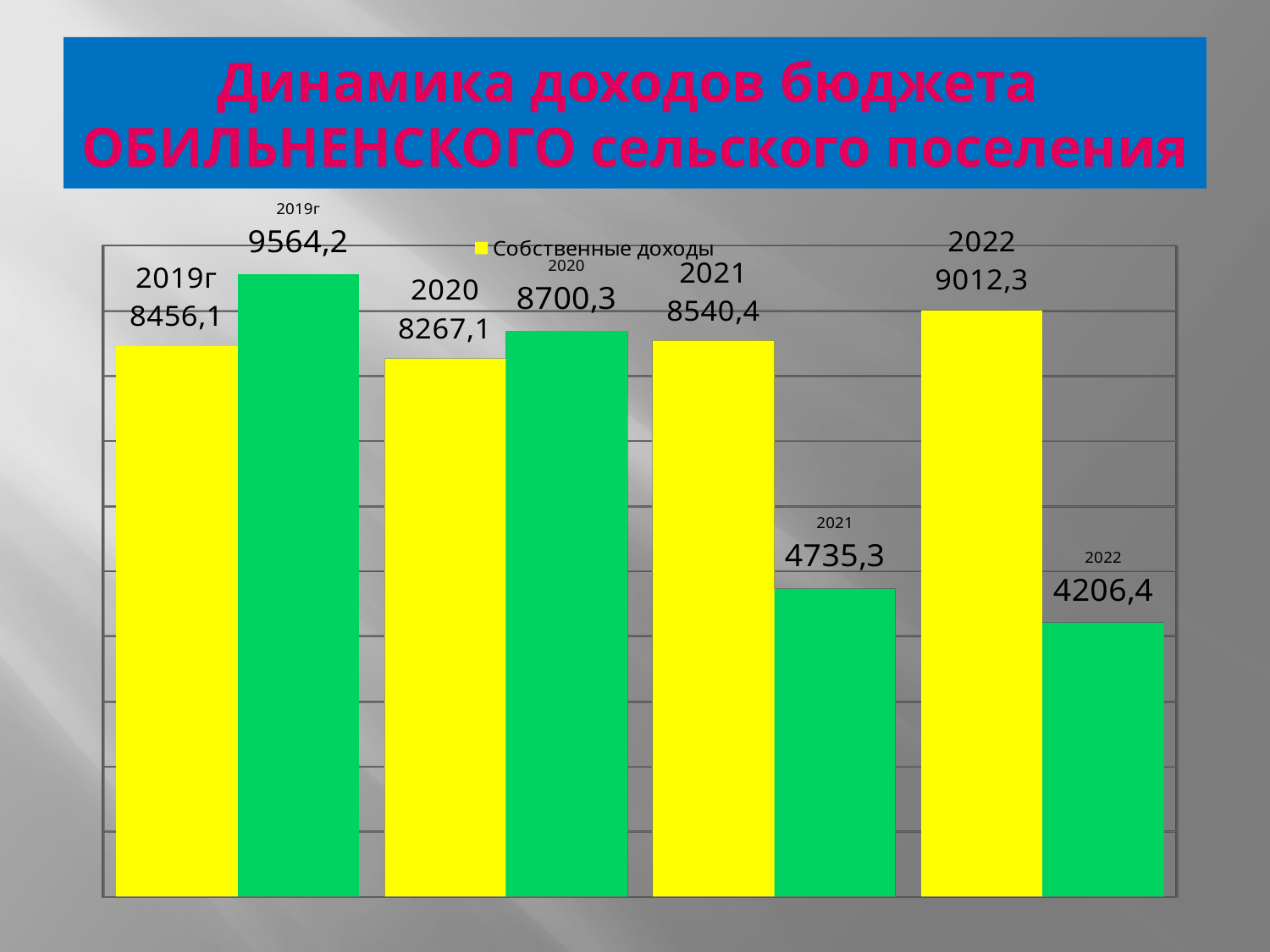
What is the value of Собственные доходы for 2019г? 8456,1 What is the value of Собственные доходы for 2022? 9012,3 Do the green bar values rise or fall from 2019г to 2022? fall In which year is Собственные доходы the highest? 2022 What is the difference between the green bar value for 2019г and the green bar value for 2022? 5357,8 What kind of chart is shown on the slide? bar chart In which year is Собственные доходы the lowest? 2020 What value is printed on the green bar for 2021? 4735,3 What value is printed on the green bar for 2020? 8700,3 What is the difference between Собственные доходы in 2022 and in 2021? 471,9 For 2019г, which is larger: the yellow bar (Собственные доходы) or the green bar? the green bar How many years are shown on the chart? 4